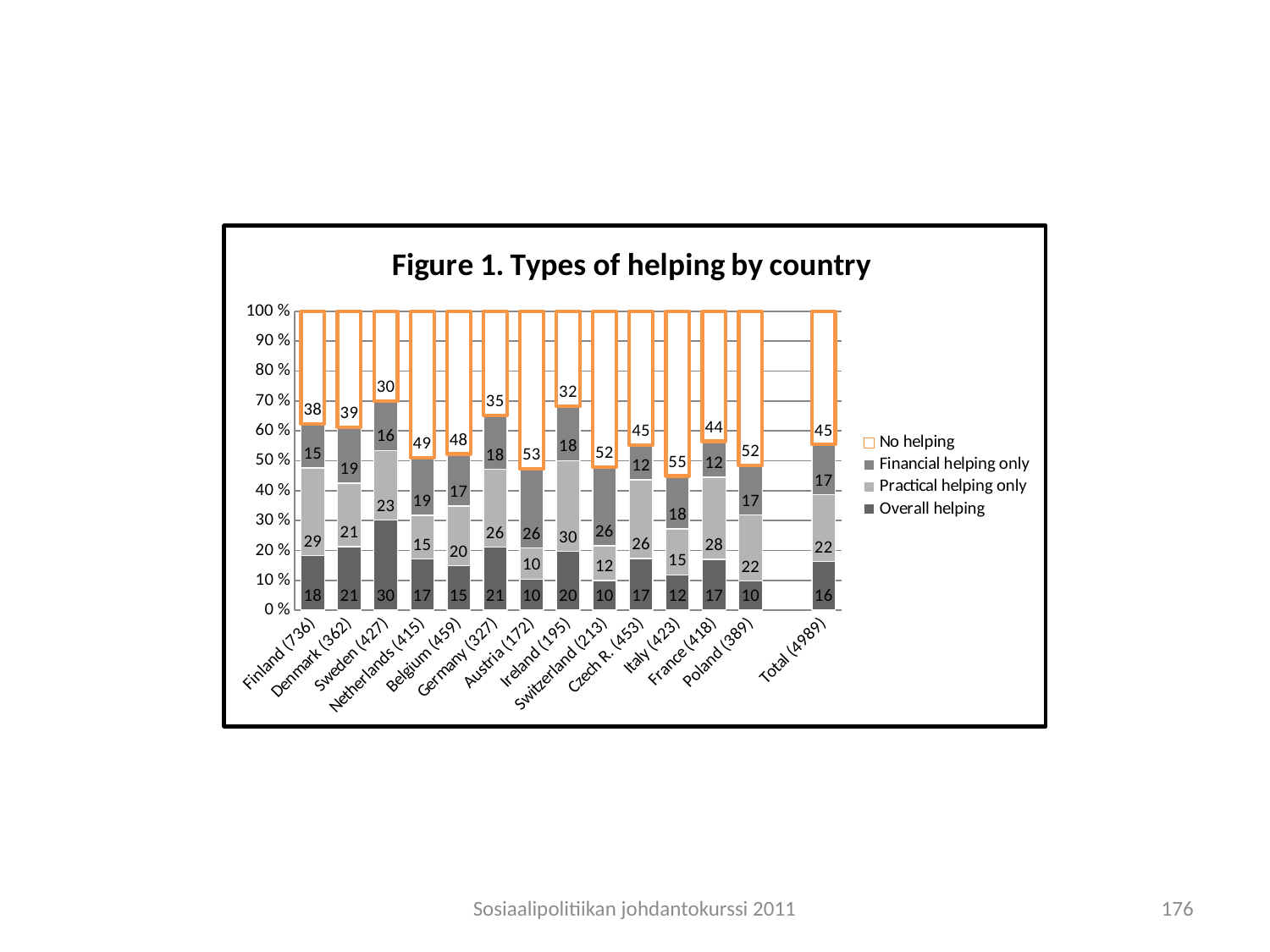
Which is larger: the 'Overall helping' value for Denmark (362) or for Poland (389)? Denmark (362) What is the value for 'No helping' for Finland (736)? 38 Which category has the lowest value for 'No helping'? Sweden (427) How many series does the legend list? 4 What is the title of the chart? Figure 1. Types of helping by country Which category has the highest value for 'No helping'? Italy (423) What is the value for 'Overall helping' for Sweden (427)? 30 What is the difference between the 'No helping' values for Italy (423) and Sweden (427)? 25 What type of chart is shown on the slide? Stacked bar chart What is the value for 'Practical helping only' for Ireland (195)? 30 How many country/total categories are shown on the x axis? 14 What is the value for 'Financial helping only' for Austria (172)? 26